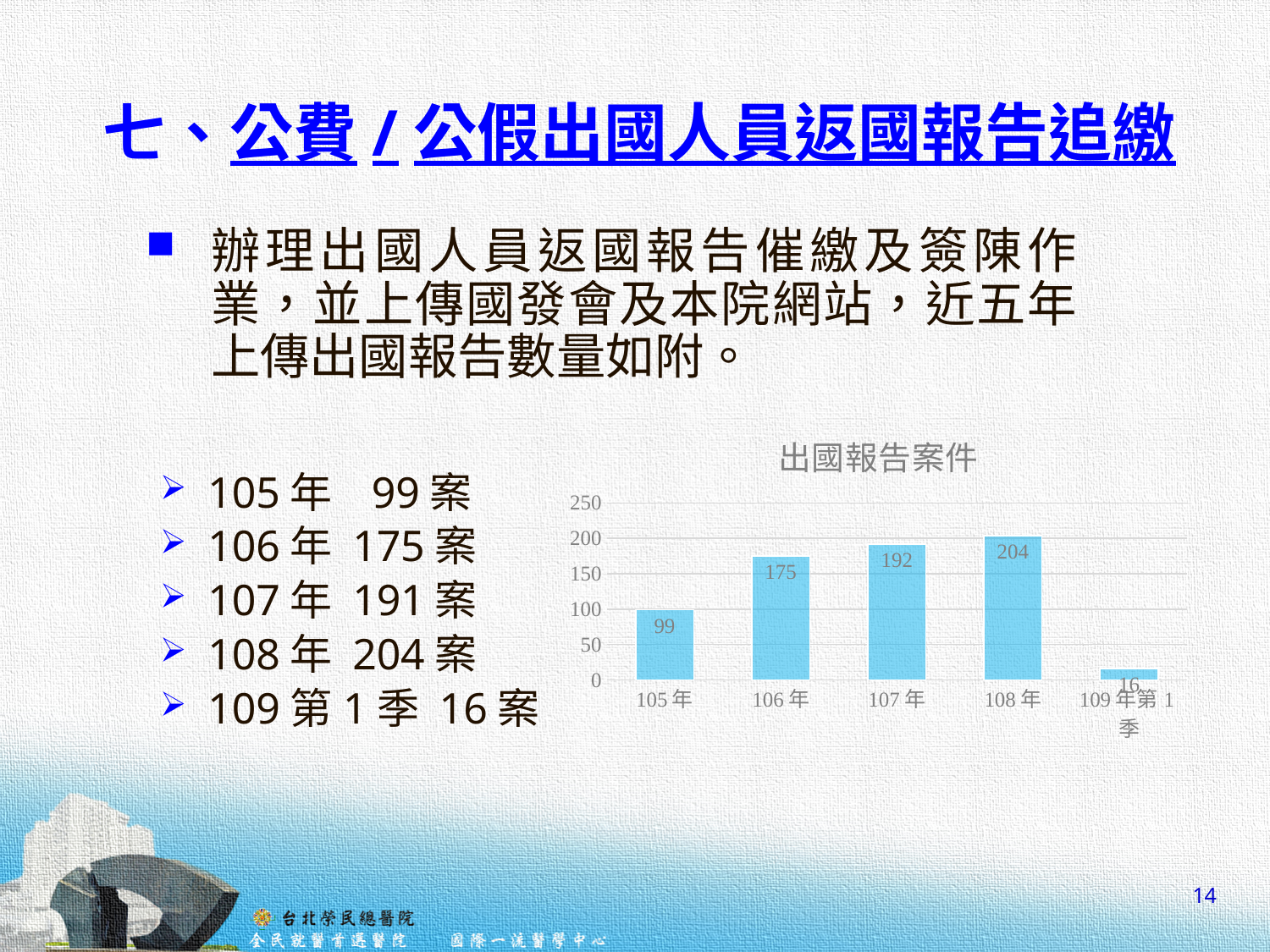
Which category has the highest value in the chart? 108年 What is the value for 109年第1季 in the chart? 16 What is the value for 105年 in the chart? 99 Which is larger, the value for 106年 or the value for 107年? 107年 Is the value for 108年 greater or less than 200? greater Which category has the lowest value in the chart? 109年第1季 What kind of chart is shown on the slide? bar chart What is the title of the chart? 出國報告案件 What is the difference between the values for 108年 and 105年? 105 What value does the chart's data label show for 107年? 192 How many categories are shown on the x axis of the chart? 5 What is the value for 106年 in the chart? 175